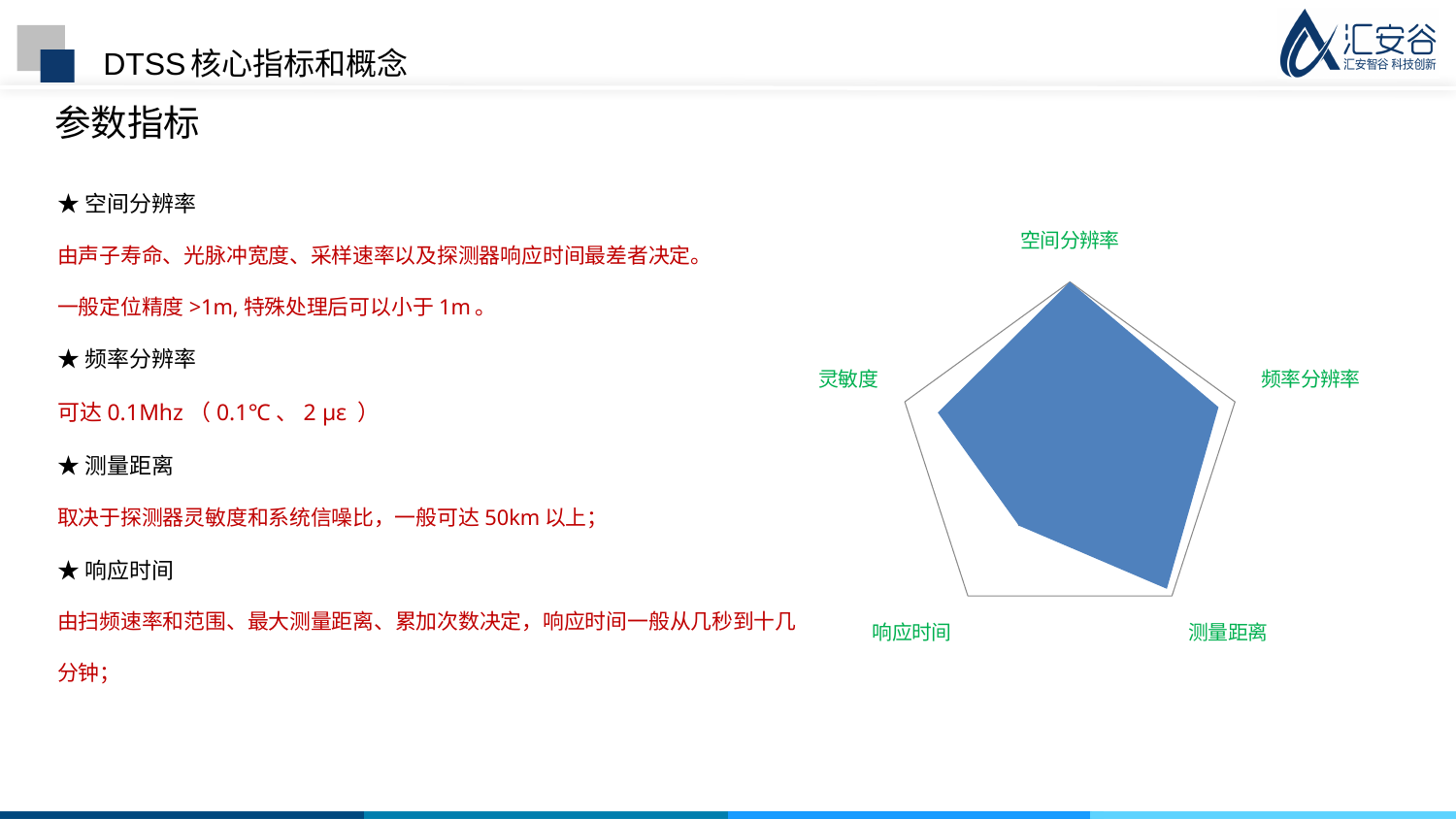
How many axes (categories) does the radar chart have? 5 On the radar chart, which is larger: the value for 空间分辨率 or the value for 响应时间? 空间分辨率 On the radar chart, which is larger: the value for 灵敏度 or the value for 响应时间? 灵敏度 Which category has the lowest value on the radar chart? 响应时间 Which category label appears at the top of the radar chart? 空间分辨率 What kind of chart is shown on the right side of the slide? radar chart What colour is the filled area of the radar chart? blue How many data series are plotted on the radar chart? 1 On the radar chart, which is larger: the value for 测量距离 or the value for 响应时间? 测量距离